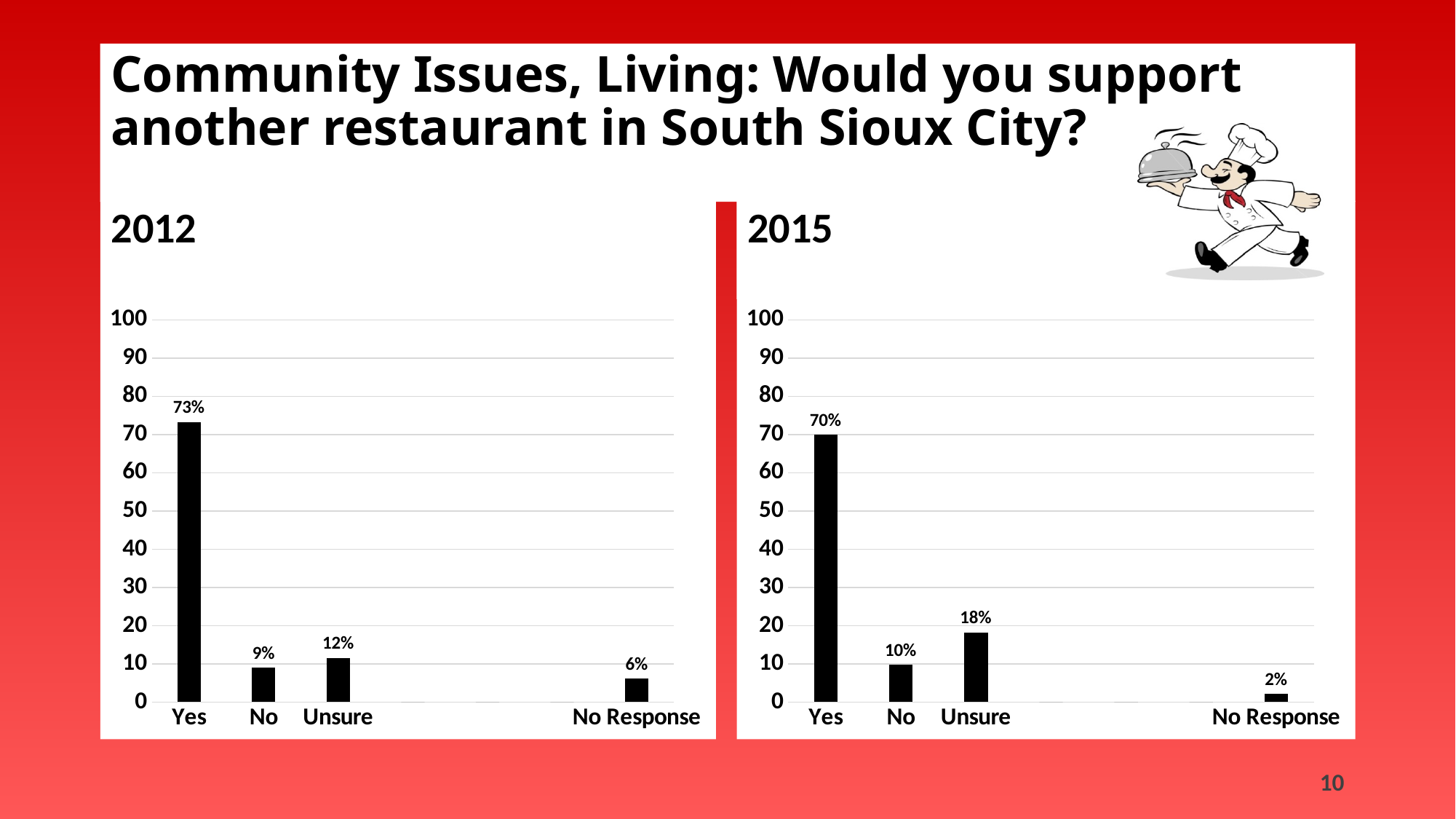
In the 2012 chart, what is the value for Yes? 73% In the 2012 chart, what is the difference between the values for Unsure and No? 3% In the 2015 chart, what is the difference between the values for Yes and Unsure? 52% In the 2012 chart, which is larger, the value for No or the value for Unsure? Unsure How many labelled categories are shown in the 2012 chart? 4 In the 2015 chart, is the value for Yes greater or less than 60? greater In the 2015 chart, what is the value for No? 10% In the 2015 chart, what is the value for Unsure? 18% In the 2012 chart, which category has the highest value? Yes In the 2015 chart, which category has the lowest value? No Response In the 2012 chart, what is the value for No Response? 6% What kind of chart is the 2015 chart? bar chart